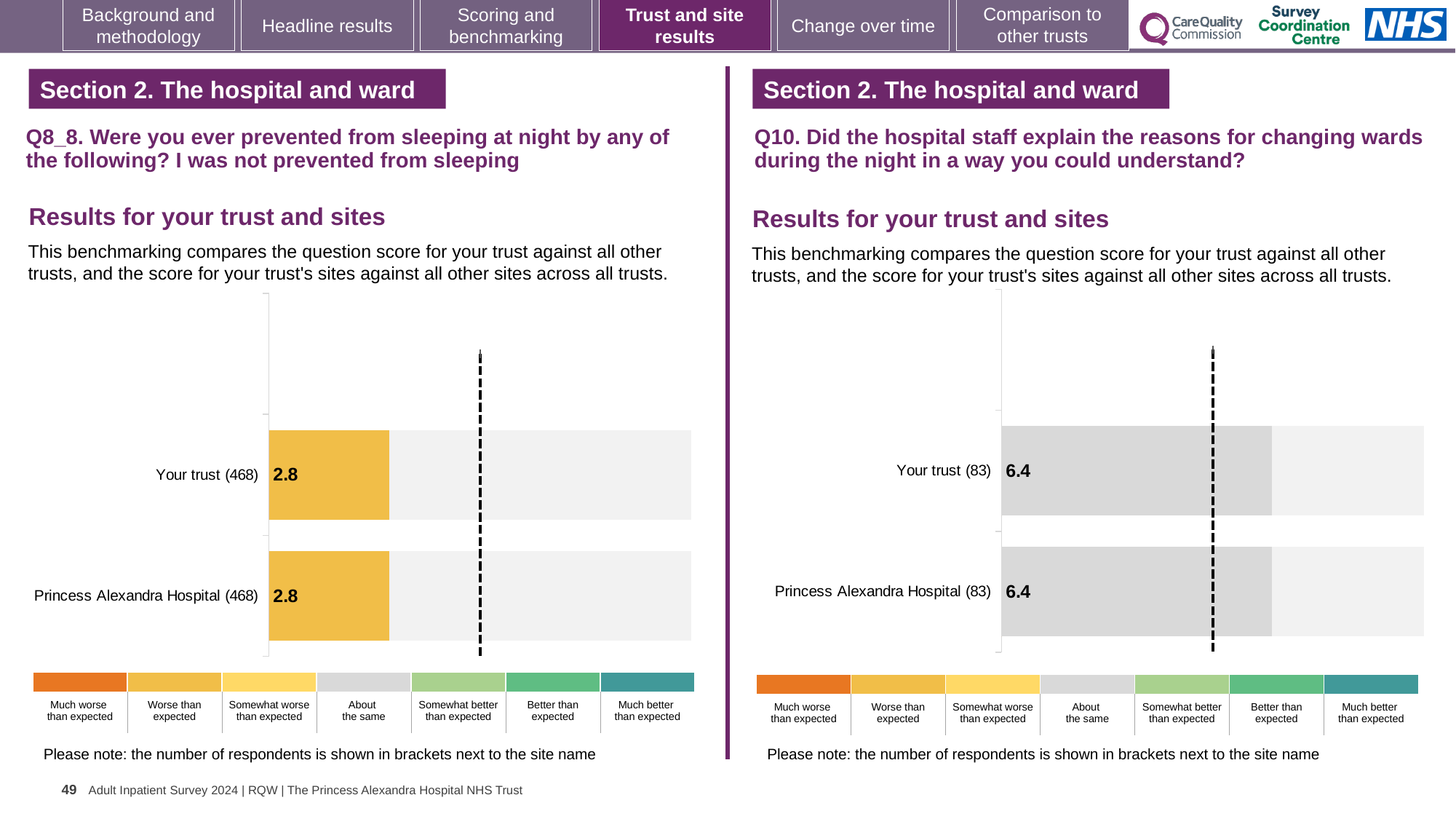
In the left chart (Q8_8), what is the score for Princess Alexandra Hospital? 2.8 In the right chart (Q10), what is the difference between the score for Your trust and the score for Princess Alexandra Hospital? 0 In the right chart (Q10), what is the score for Your trust? 6.4 How many bars are plotted in the left chart (Q8_8)? 2 In the left chart (Q8_8), what is the score for Your trust? 2.8 According to the colour key, which benchmark category do the grey bars in the right chart (Q10) represent? About the same In the left chart (Q8_8), how many respondents are shown in brackets for Your trust? 468 How many bars are plotted in the right chart (Q10)? 2 In the left chart (Q8_8), what is the difference between the score for Your trust and the score for Princess Alexandra Hospital? 0 In the right chart (Q10), how many respondents are shown in brackets for Princess Alexandra Hospital? 83 In the right chart (Q10), what is the score for Princess Alexandra Hospital? 6.4 What kind of chart is used for the Q10 results on the right? Bar chart